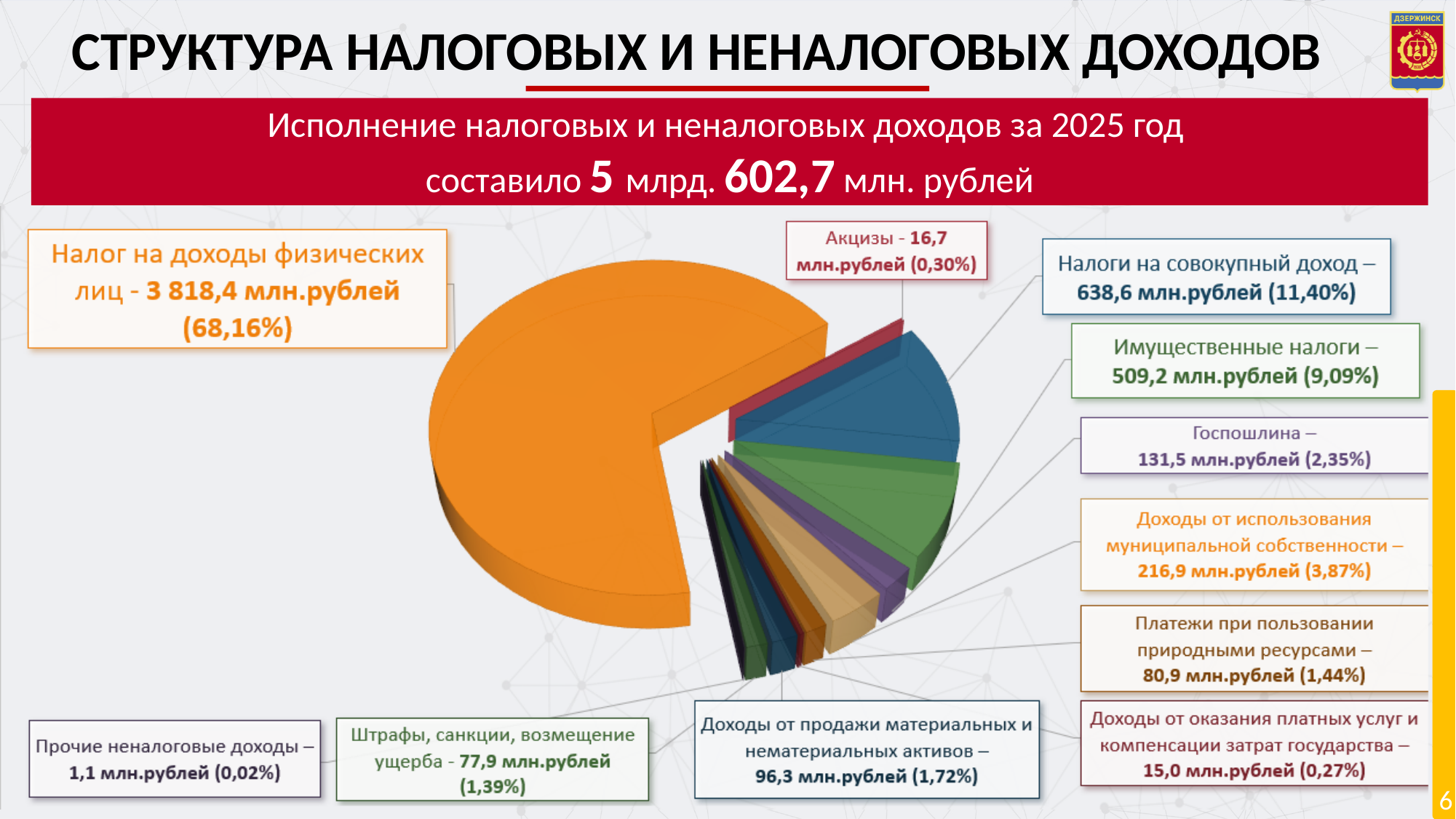
What is the value for Акцизы? 16,7 млн.рублей What share of the pie does Налог на доходы физических лиц represent? 68,16% Which is larger: Госпошлина or Доходы от использования муниципальной собственности? Доходы от использования муниципальной собственности What is the value for Налоги на совокупный доход? 638,6 млн.рублей What is the value for Налог на доходы физических лиц? 3 818,4 млн.рублей What colour is the largest slice of the pie chart? Orange Which category has the smallest slice of the pie? Прочие неналоговые доходы What type of chart is shown on the slide? Pie chart How many categories (slices) does the pie chart have? 11 What share of the pie does Имущественные налоги represent? 9,09% Which category has the largest slice of the pie? Налог на доходы физических лиц What is the difference in млн.рублей between Налоги на совокупный доход and Имущественные налоги? 129,4 млн.рублей